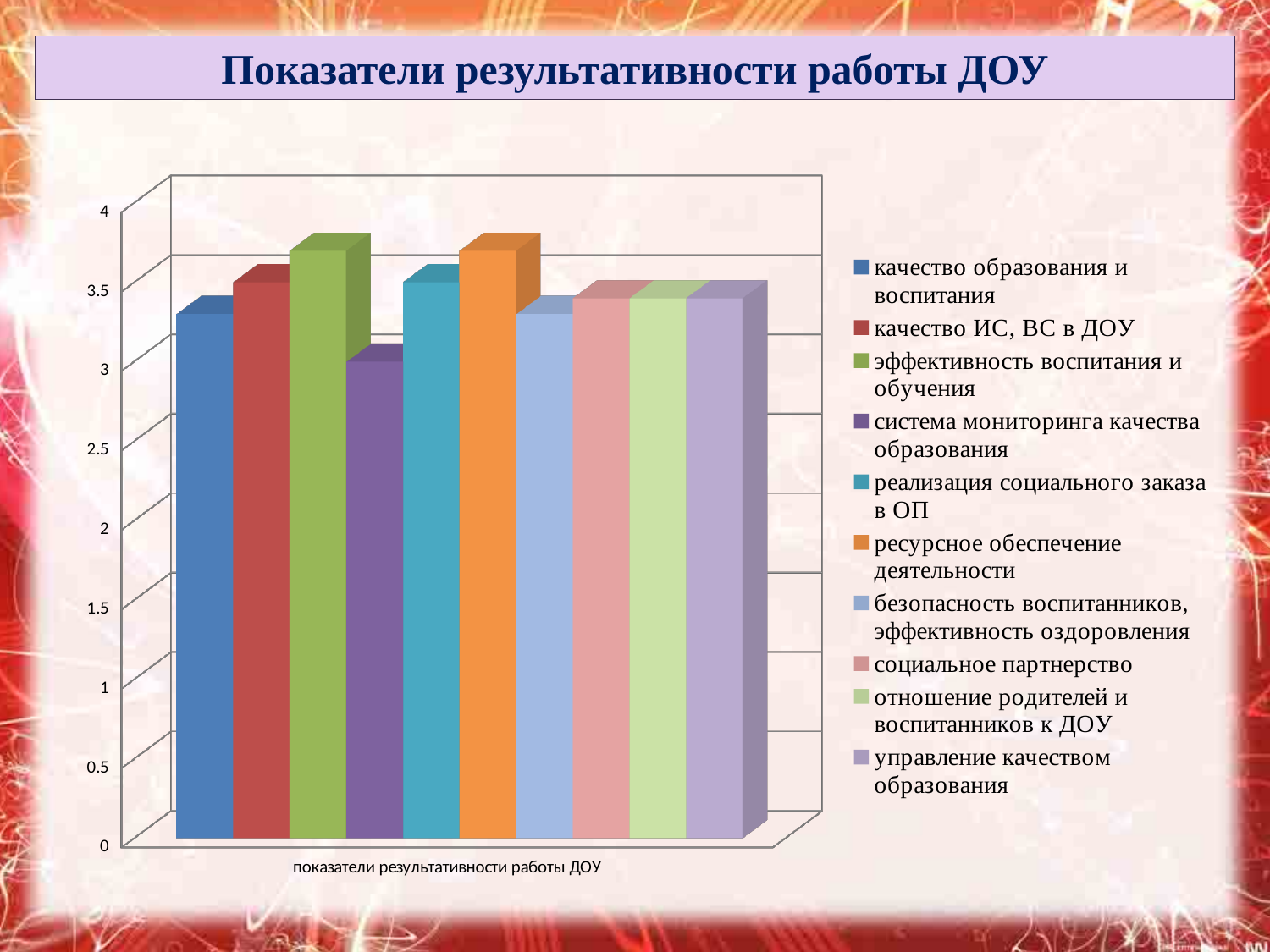
Which legend entry is shown in orange? ресурсное обеспечение деятельности Is the value for "ресурсное обеспечение деятельности" greater or less than 3.5? greater Which series has the lowest bar? система мониторинга качества образования Is the value for "качество образования и воспитания" greater or less than 3.5? less What kind of chart is shown on the slide? bar chart How many categories are shown on the x axis? 1 Which is larger: the bar for "ресурсное обеспечение деятельности" or the bar for "безопасность воспитанников, эффективность оздоровления"? ресурсное обеспечение деятельности Which is larger: the bar for "эффективность воспитания и обучения" or the bar for "система мониторинга качества образования"? эффективность воспитания и обучения Is the value for "эффективность воспитания и обучения" greater or less than 3.5? greater What is the title of the slide above the chart? Показатели результативности работы ДОУ How many series does the legend list? 10